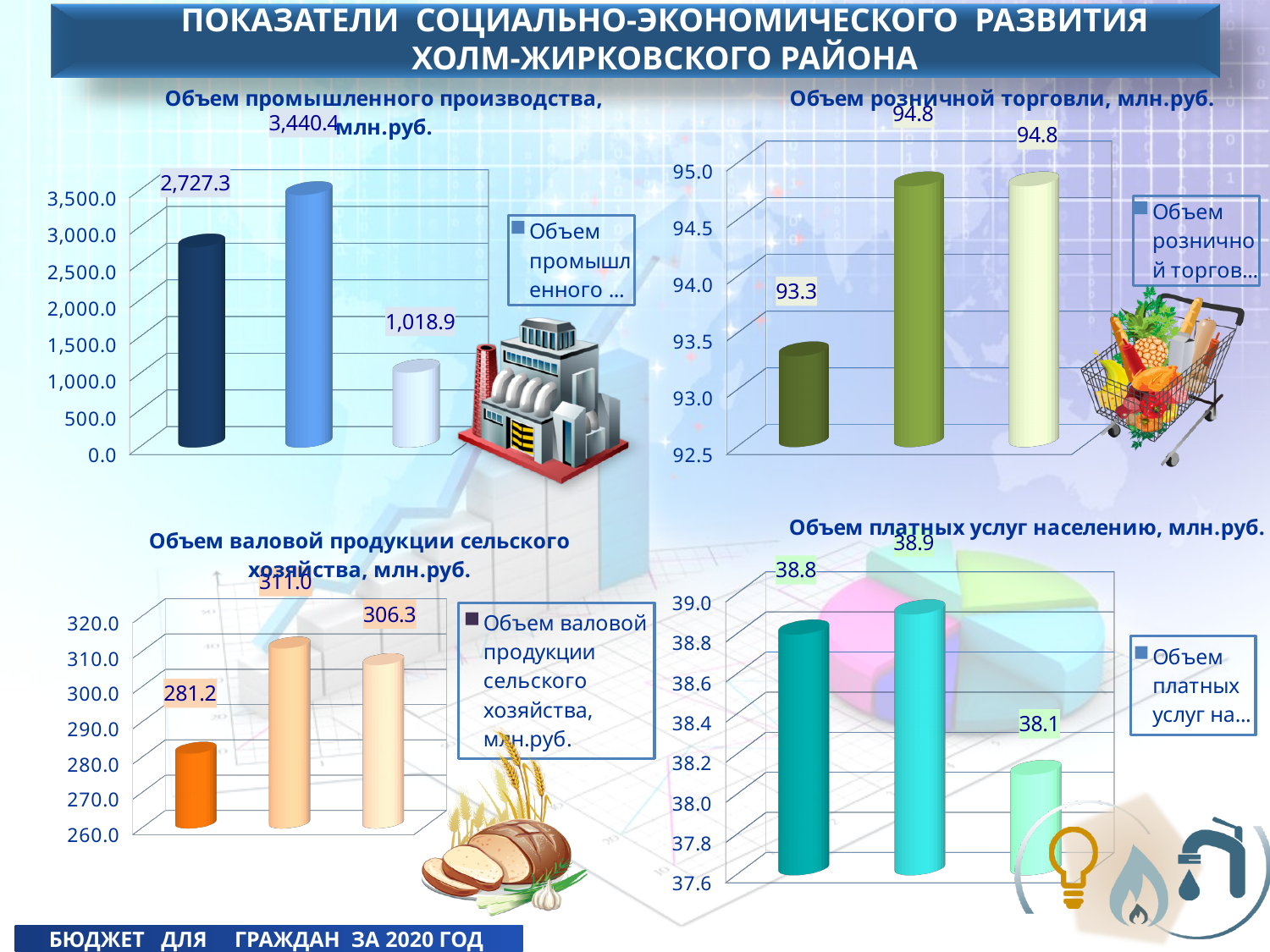
In the chart 'Объем платных услуг населению, млн.руб.', what is the value of the second bar? 38.9 In the chart 'Объем валовой продукции сельского хозяйства, млн.руб.', what is the value of the first bar? 281.2 In the chart 'Объем валовой продукции сельского хозяйства, млн.руб.', which bar is the highest? the second bar (311.0) In the chart 'Объем промышленного производства, млн.руб.', what is the value of the third bar? 1,018.9 In the chart 'Объем платных услуг населению, млн.руб.', which bar is the lowest? the third bar (38.1) In the chart 'Объем валовой продукции сельского хозяйства, млн.руб.', what is the difference between the second and third bars? 4.7 In the chart 'Объем розничной торговли, млн.руб.', how many bars are plotted? 3 What type of chart is 'Объем платных услуг населению, млн.руб.'? bar chart In the chart 'Объем промышленного производства, млн.руб.', what is the value of the second bar? 3,440.4 How many series does the legend of the chart 'Объем розничной торговли, млн.руб.' list? 1 In the chart 'Объем розничной торговли, млн.руб.', what is the value of the first bar? 93.3 In the chart 'Объем промышленного производства, млн.руб.', what is the difference between the highest and lowest bars? 2,421.5